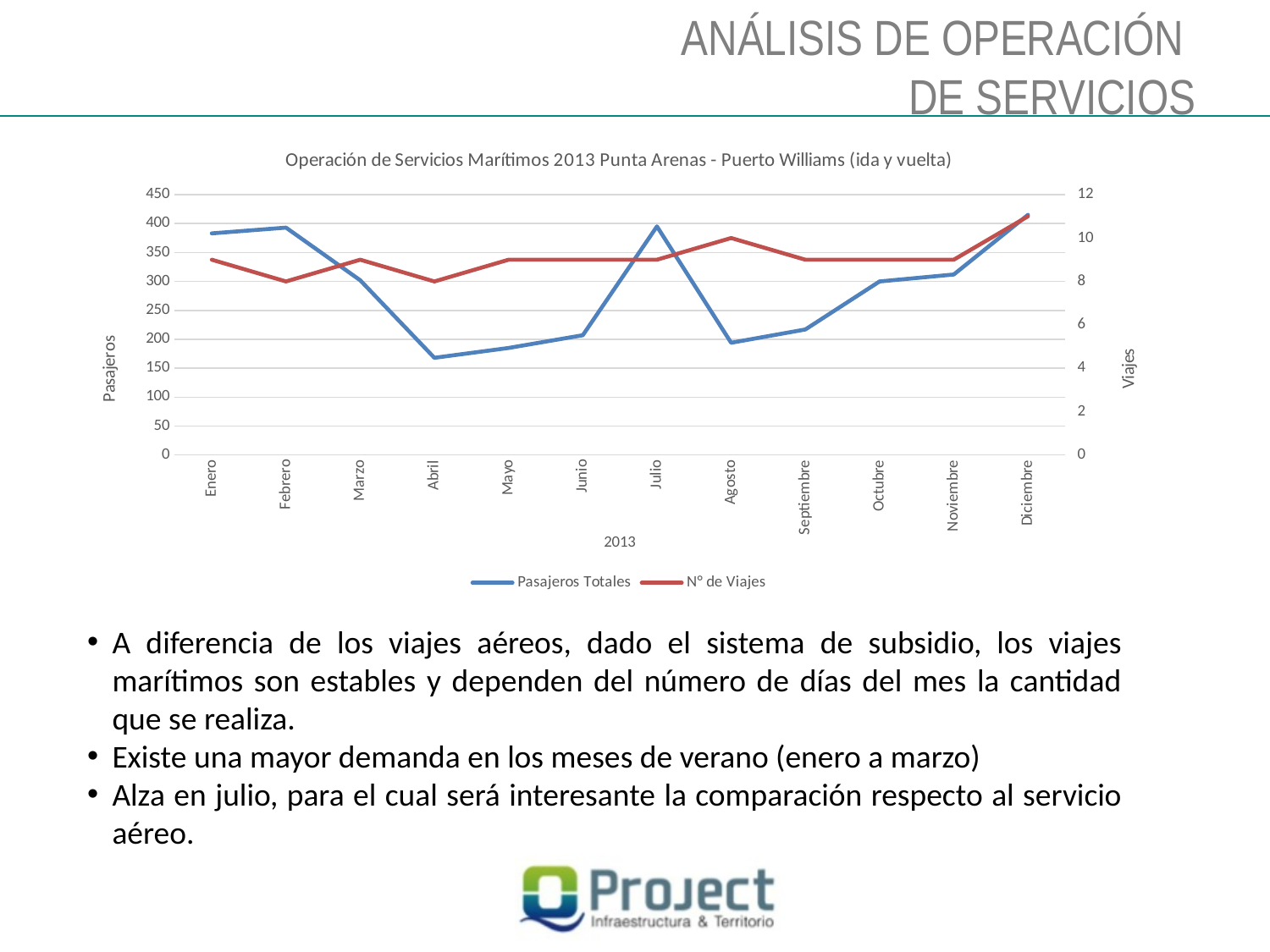
What kind of chart is shown on the slide? Line chart How many series does the legend list? 2 Which month has the highest value for N° de Viajes? Diciembre Which month has the highest value for Pasajeros Totales? Diciembre Do the Pasajeros Totales values rise or fall from Febrero to Abril? fall Is the value of Pasajeros Totales for Abril greater or less than 200? less Which month has the larger value for Pasajeros Totales, Julio or Agosto? Julio Is the value of N° de Viajes for Diciembre greater or less than 10? greater Which month has the lowest value for Pasajeros Totales? Abril Is the value of Pasajeros Totales for Enero greater or less than 350? greater How many months are plotted along the x axis? 12 What is the label of the right-hand vertical axis? Viajes